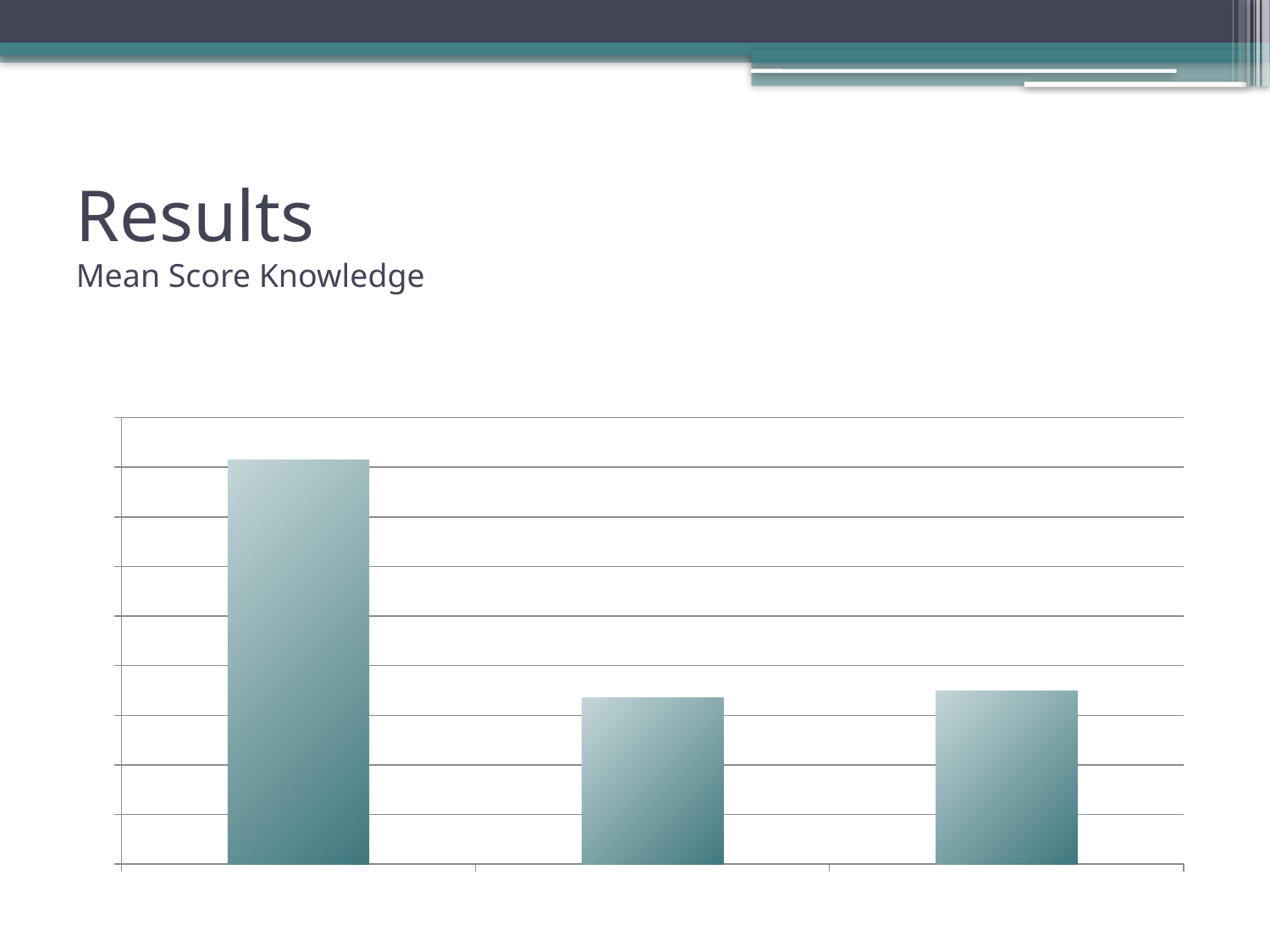
Which bar is the tallest in the chart: the leftmost, middle, or rightmost? leftmost What subtitle appears under the slide title 'Results' above the chart? Mean Score Knowledge How many bars are plotted in the chart? 3 Which is taller in the chart, the leftmost bar or the middle bar? the leftmost bar What kind of chart is shown on the slide? bar chart Does the chart display a legend? No Which is taller in the chart, the leftmost bar or the rightmost bar? the leftmost bar